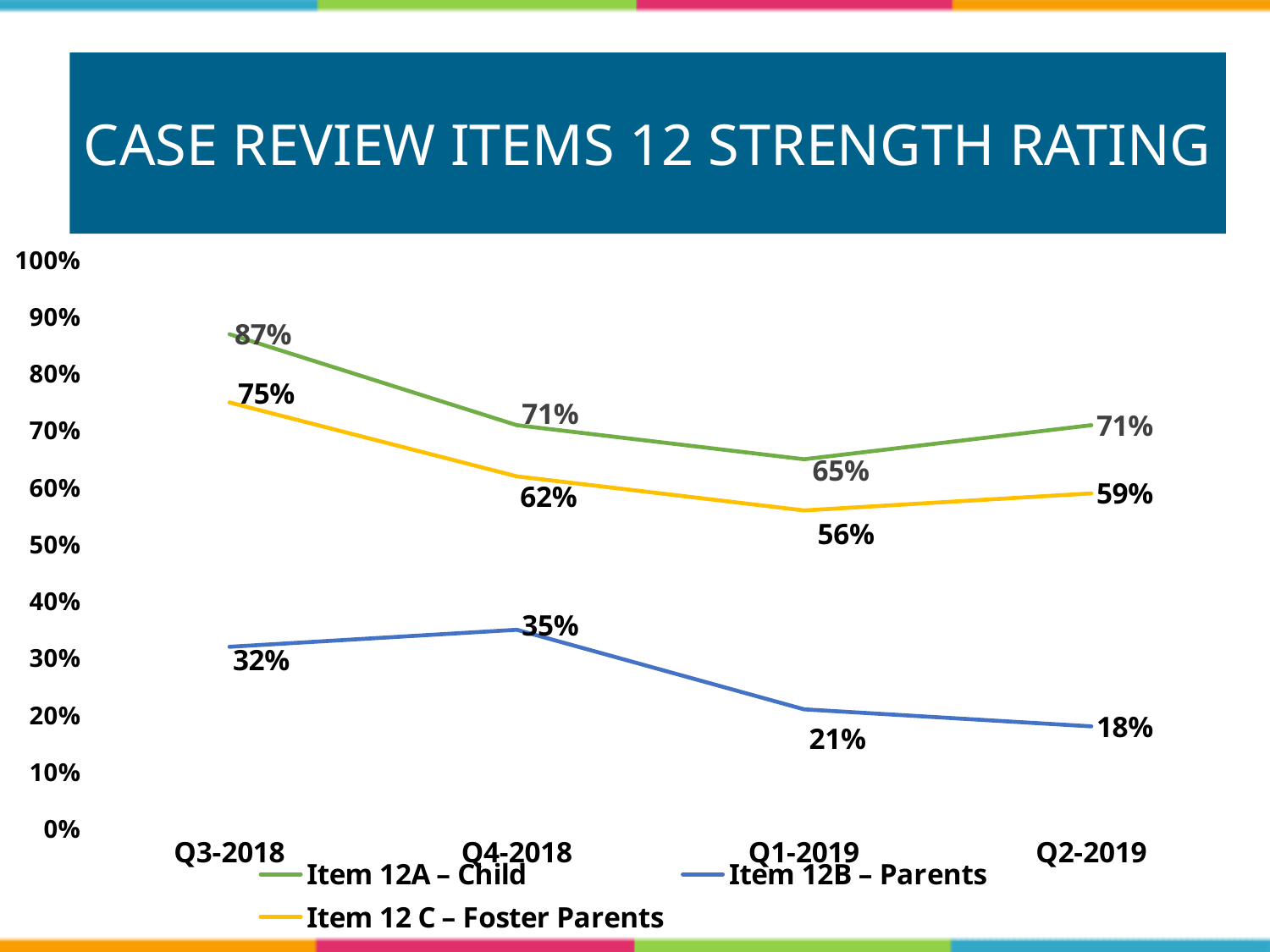
What is the value for Item 12B – Parents in Q4-2018? 35% How many series does the legend list? 3 What type of chart is shown on the slide? line chart What is the value for Item 12A – Child in Q3-2018? 87% In which quarter is Item 12B – Parents lowest? Q2-2019 What is the title of the chart? CASE REVIEW ITEMS 12 STRENGTH RATING Does Item 12B – Parents rise or fall from Q4-2018 to Q2-2019? fall What is the difference between Item 12A – Child and Item 12B – Parents in Q2-2019? 53% What is the value for Item 12 C – Foster Parents in Q1-2019? 56% In which quarter is Item 12 C – Foster Parents highest? Q3-2018 How many quarters are shown on the x axis? 4 Which is larger in Q4-2018: Item 12A – Child or Item 12 C – Foster Parents? Item 12A – Child